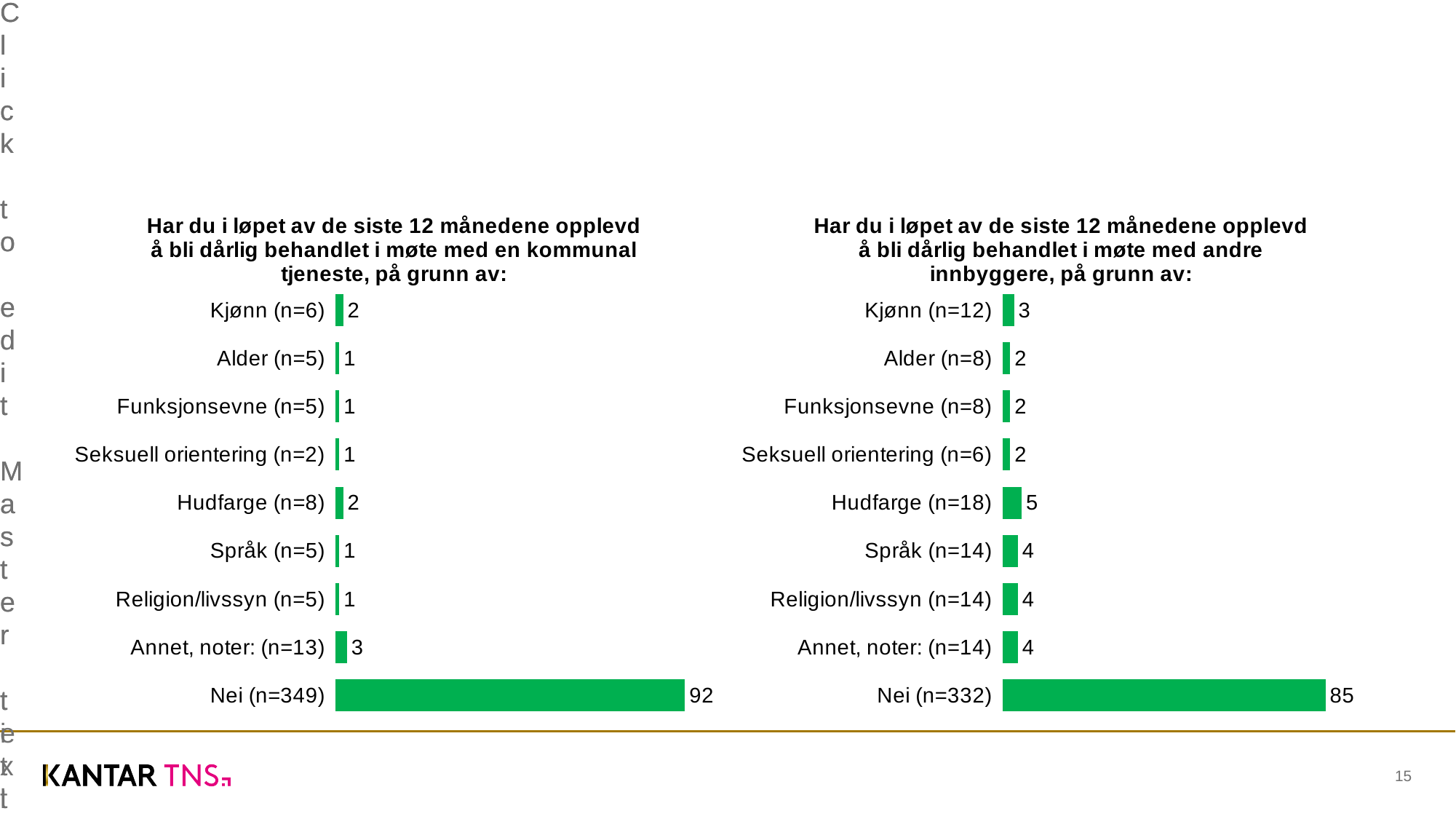
What type of chart is used on this slide? Bar chart In the right chart (andre innbyggere), what is the difference between Hudfarge (n=18) and Alder (n=8)? 3 In the left chart (kommunal tjeneste), what is the value for Annet, noter: (n=13)? 3 In the left chart (kommunal tjeneste), which category has the highest value? Nei (n=349) In the left chart (kommunal tjeneste), what is the value for Nei (n=349)? 92 In the right chart (andre innbyggere), which category has the highest value? Nei (n=332) What colour are the bars in both charts? Green What is the difference between the Nei value in the left chart (92) and the Nei value in the right chart (85)? 7 How many categories are shown in the left chart (kommunal tjeneste)? 9 In the right chart (andre innbyggere), what is the value for Hudfarge (n=18)? 5 In the right chart (andre innbyggere), which is larger: Hudfarge (n=18) or Språk (n=14)? Hudfarge (n=18) In the right chart (andre innbyggere), what is the value for Kjønn (n=12)? 3